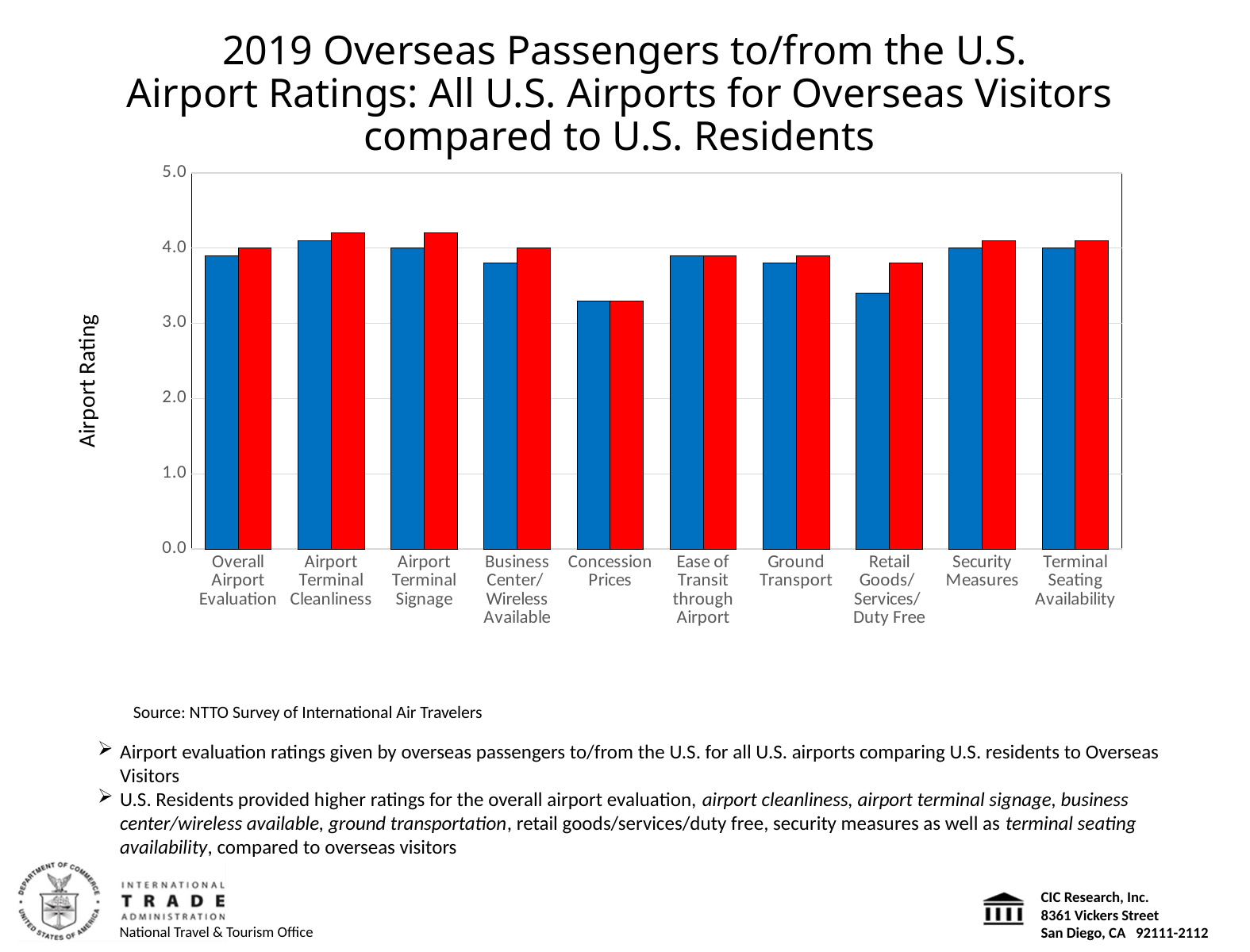
Is the blue bar for Ground Transport greater or less than 4.0? less What kind of chart is shown on the slide? bar chart Is the blue bar for Concession Prices greater or less than 3.0? greater Is the blue bar for Retail Goods/Services/Duty Free greater or less than 4.0? less What is the label on the vertical axis of the chart? Airport Rating How many airport rating categories are shown along the x axis? 10 Which is larger: the red bar for Retail Goods/Services/Duty Free or the red bar for Concession Prices? Retail Goods/Services/Duty Free For Retail Goods/Services/Duty Free, which bar is taller, the blue bar or the red bar? red bar Which category has the lowest ratings for both bars? Concession Prices What is the highest value shown on the vertical axis? 5.0